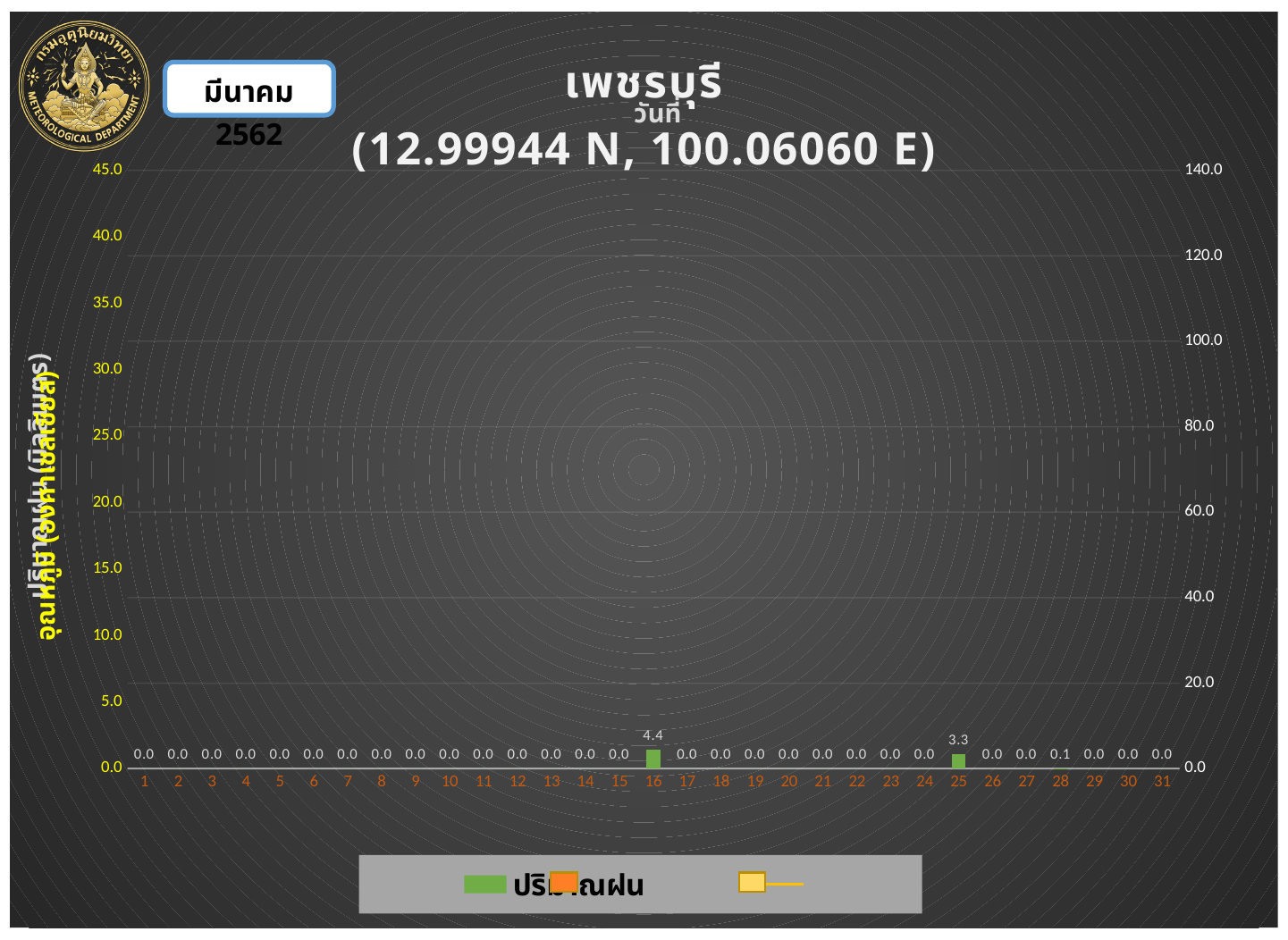
What is the rainfall value shown for day 10? 0.0 What colour are the rainfall bars in the chart? green Is the rainfall value for day 16 greater or less than 5.0 on the left axis? less What is the rainfall value shown for day 16? 4.4 What is the rainfall value shown for day 25? 3.3 What kind of chart is shown on the slide? bar chart What is the rainfall value shown for day 28? 0.1 Which day has the highest rainfall value? 16 How many days are shown on the x axis? 31 What is the difference between the rainfall values for day 16 and day 25? 1.1 What is the maximum value shown on the right-hand axis? 140.0 Which is larger, the rainfall value for day 25 or for day 28? day 25